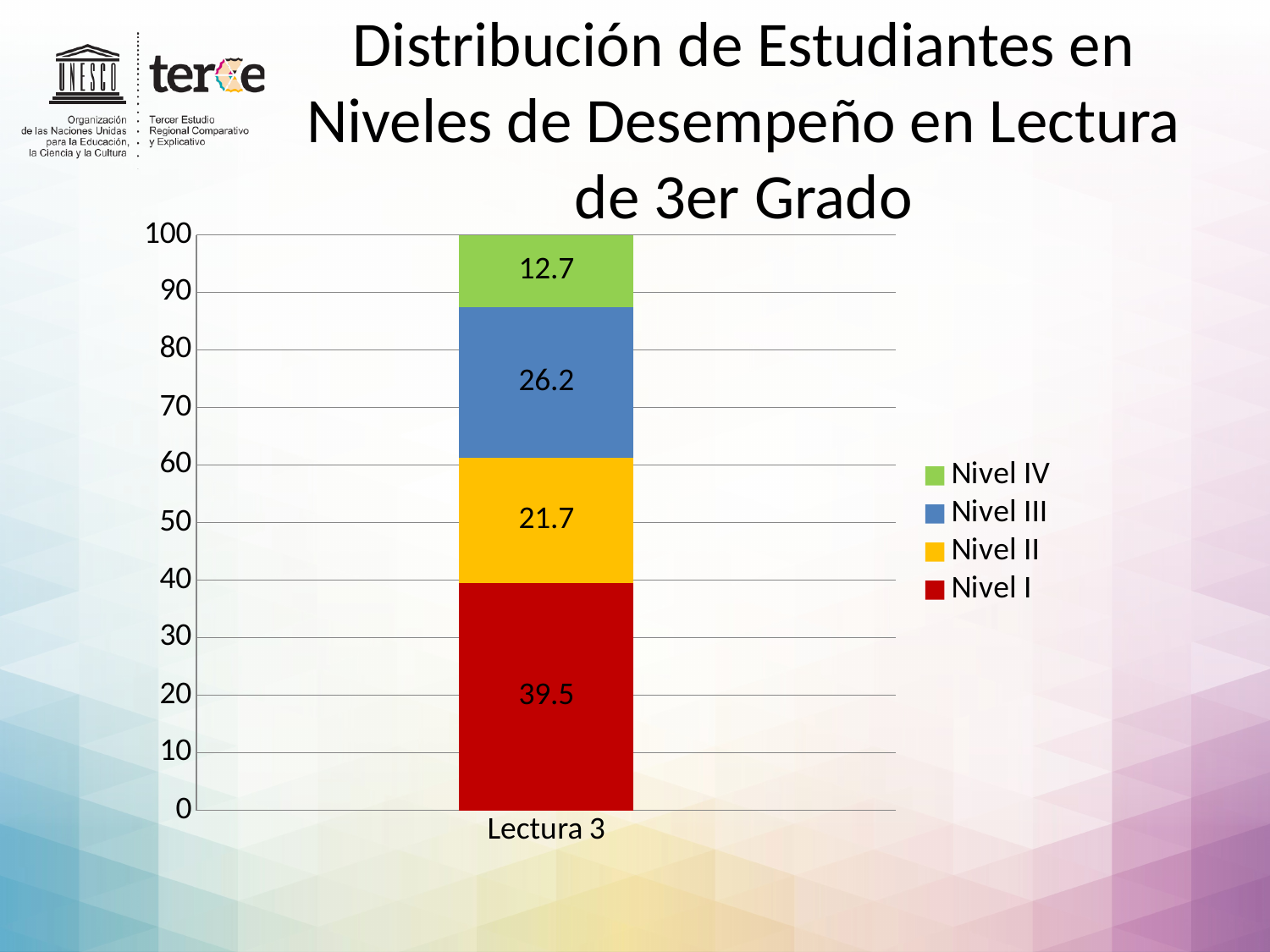
What is the value for Nivel IV in the Lectura 3 bar? 12.7 What colour represents Nivel I in the chart? Red What kind of chart is shown on the slide? Stacked bar chart Which level has the highest value in the Lectura 3 bar? Nivel I Which level has the lowest value in the Lectura 3 bar? Nivel IV What is the difference between the Nivel I and Nivel IV values? 26.8 How many series does the legend list? 4 Which is larger, the value for Nivel III or the value for Nivel II? Nivel III What is the value for Nivel III in the Lectura 3 bar? 26.2 What is the value for Nivel II in the Lectura 3 bar? 21.7 What is the total of the stacked Lectura 3 bar? 100.1 What is the value for Nivel I in the Lectura 3 bar? 39.5